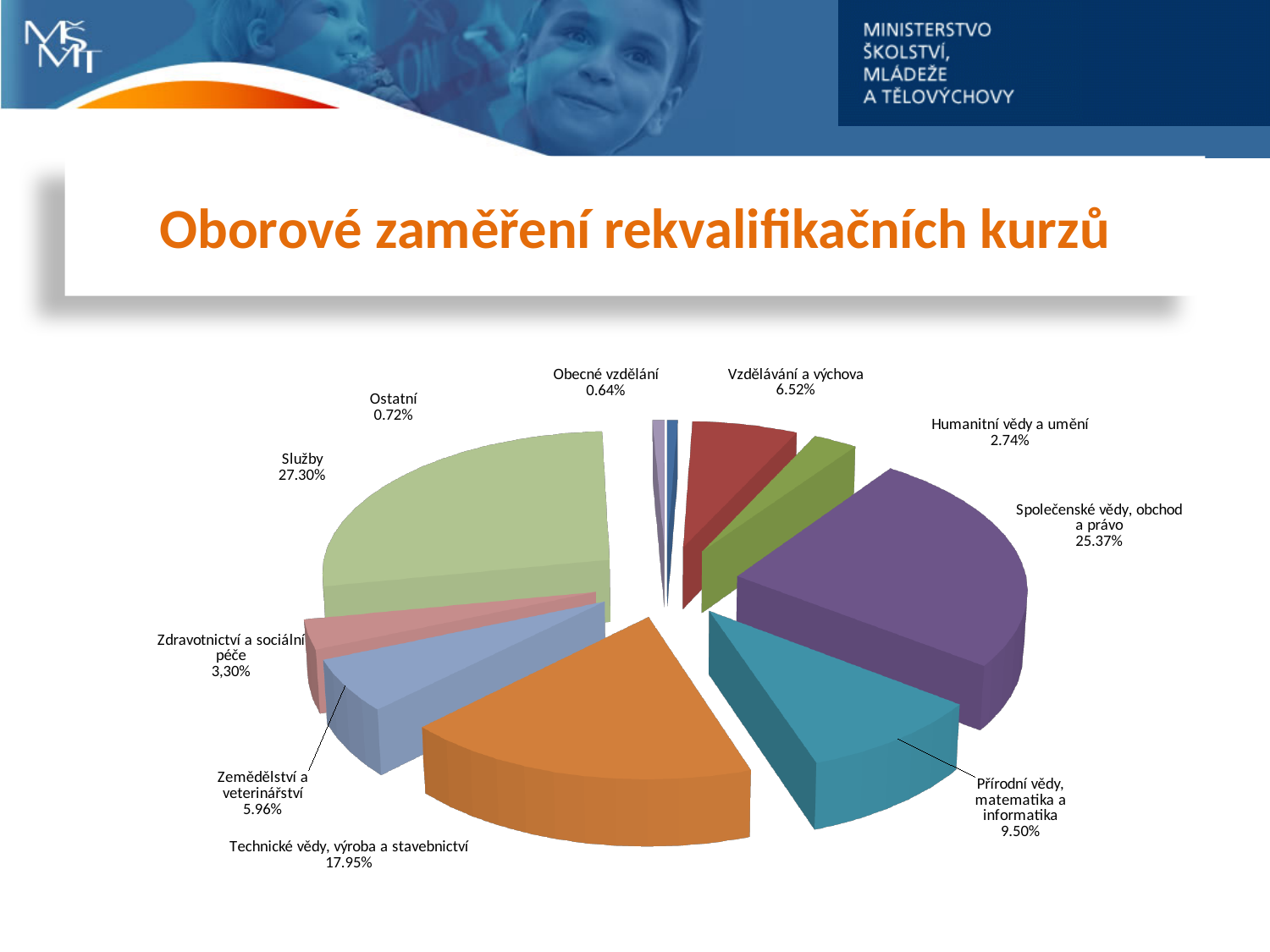
How many categories are shown in the pie chart? 10 What is the value shown for Společenské vědy, obchod a právo? 25.37% Which category has the smallest share of the pie? Obecné vzdělání Which category has the largest share of the pie? Služby What share of the pie does Služby have? 27.30% What is the value shown for Technické vědy, výroba a stavebnictví? 17.95% What is the title of the chart slide? Oborové zaměření rekvalifikačních kurzů Which is larger, the share for Vzdělávání a výchova or the share for Zemědělství a veterinářství? Vzdělávání a výchova What is the difference in percentage points between Služby and Společenské vědy, obchod a právo? 1.93 What is the value shown for Přírodní vědy, matematika a informatika? 9.50% What kind of chart is shown on the slide? pie chart What is the value shown for Zdravotnictví a sociální péče? 3,30%